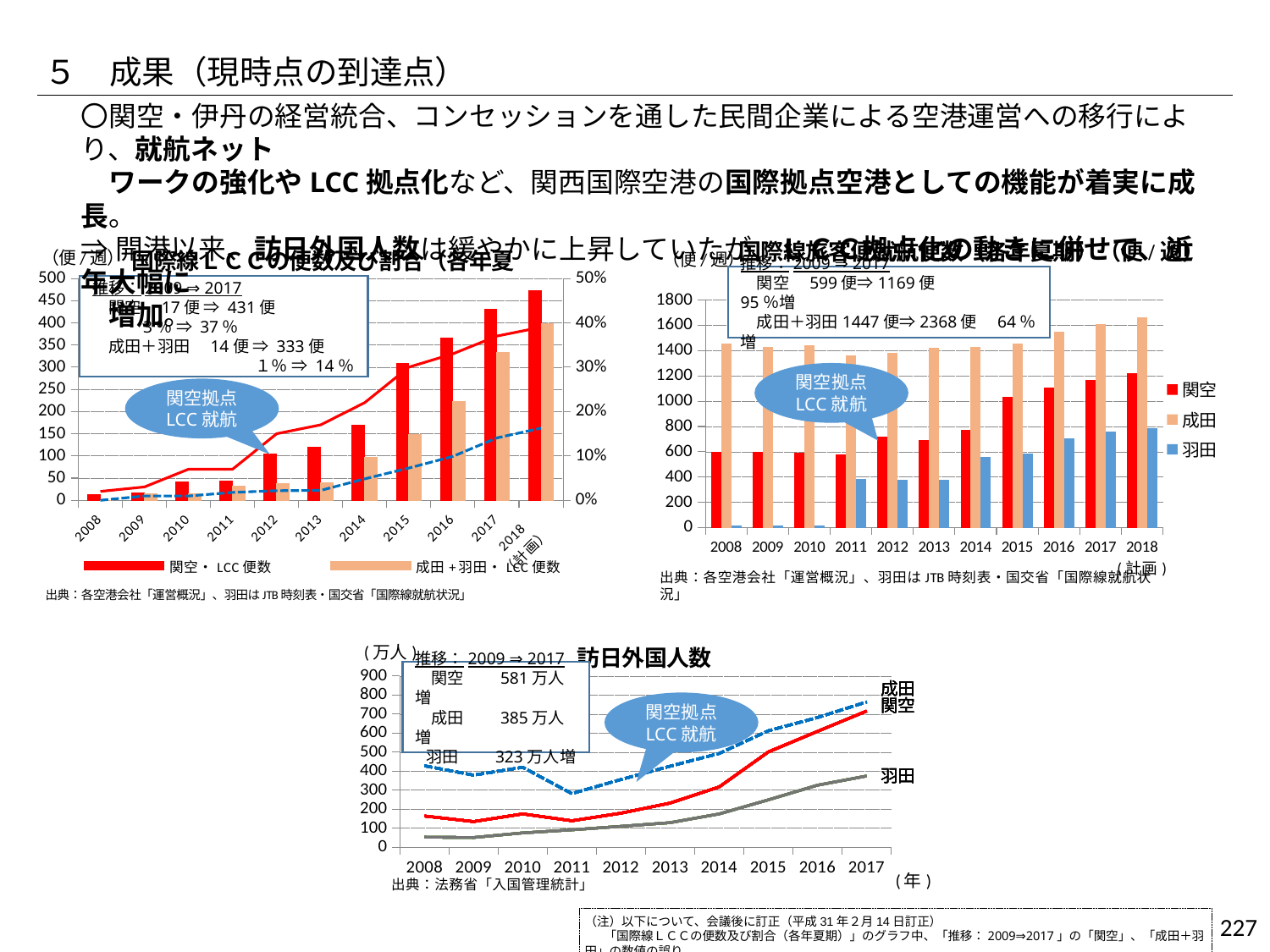
In the bottom chart (訪日外国人数), which line has the highest value in 2017? 成田 In the bottom chart (訪日外国人数), does the 関空 line rise or fall from 2011 to 2017? rise In the top-right chart, which series has the highest value in 2008? 成田 In the top-right chart, how many series does the legend list? 3 What kind of chart is the bottom chart titled 訪日外国人数? line chart In the bottom chart (訪日外国人数), is the value for 羽田 in 2008 greater or less than 100? less In the top-right chart, is the value for 成田 in 2017 greater or less than 1400? greater In the top-right chart, is the value for 羽田 in 2008 greater or less than 200? less In the top-left chart (国際線LCCの便数及び割合), how many series does the legend list? 2 In the top-left chart (国際線LCCの便数及び割合), which series has the larger bar in 2015, 関空・LCC便数 or 成田+羽田・LCC便数? 関空・LCC便数